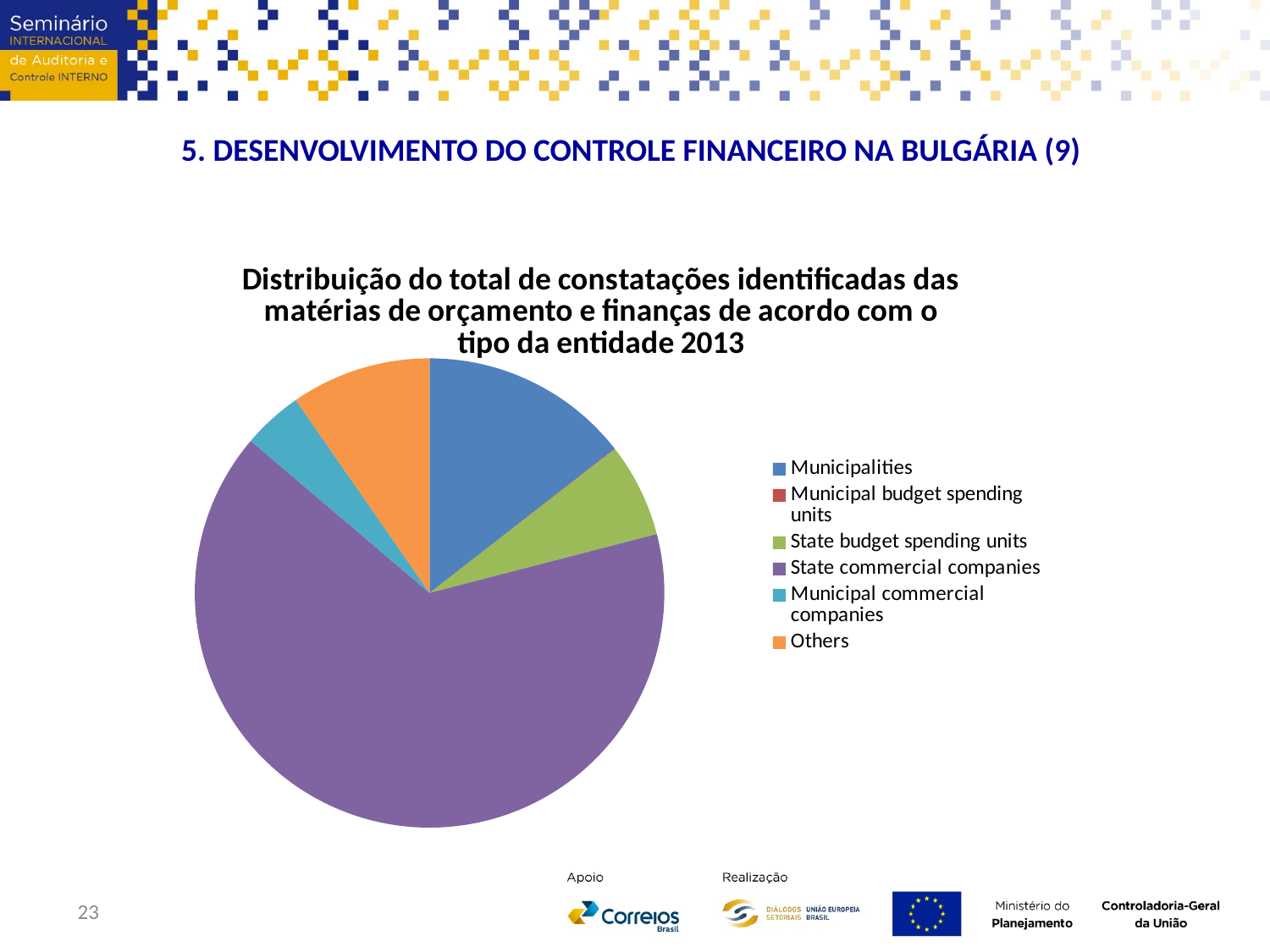
Which category has the largest slice of the pie? State commercial companies Which is larger, the slice for Municipalities or the slice for State budget spending units? Municipalities What colour is the slice for State commercial companies? purple How many entries does the legend of the pie chart list? 6 What year is mentioned in the title of the pie chart? 2013 Which is larger, the slice for State commercial companies or the slice for Municipalities? State commercial companies What kind of chart is shown on the slide? pie chart Which is larger, the slice for Others or the slice for Municipal commercial companies? Others